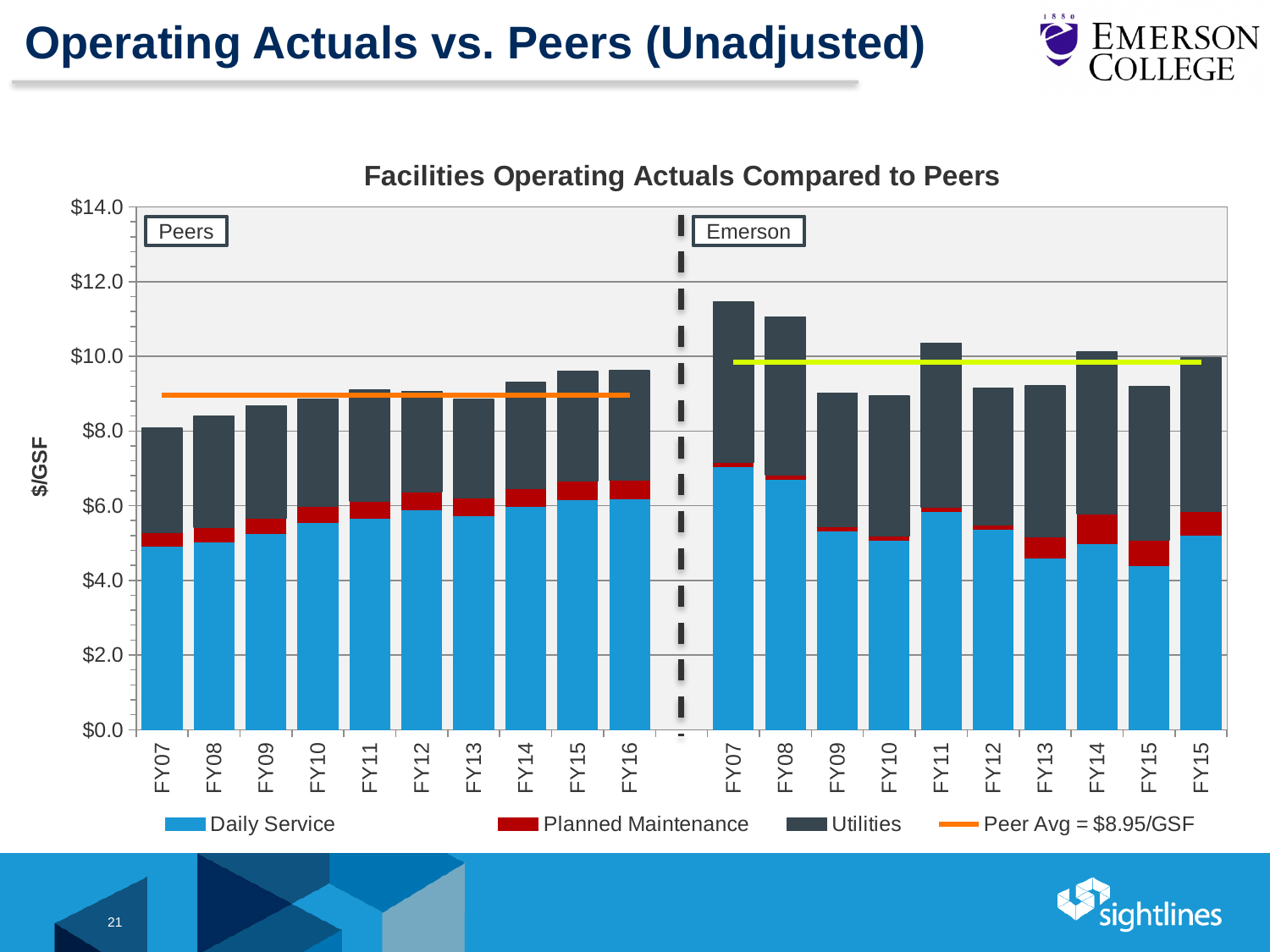
What is the title of the chart? Facilities Operating Actuals Compared to Peers Is the total for Emerson FY07 greater or less than $10.0? greater How many entries does the chart legend list? 4 What kind of chart is shown on the slide? Stacked bar chart How many bars are shown in the Emerson section of the chart? 10 Which bar has the lowest total in the Peers section? FY07 Is the total for Peers FY16 greater or less than $8.0? greater How many bars are shown in the Peers section of the chart? 10 Which is larger, the total for Emerson FY08 or the total for Peers FY16? Emerson FY08 Is the total for Emerson FY13 greater or less than $10.0? less Which bar has the highest total across the whole chart? Emerson FY07 What is the Peer Avg value shown in the legend? $8.95/GSF